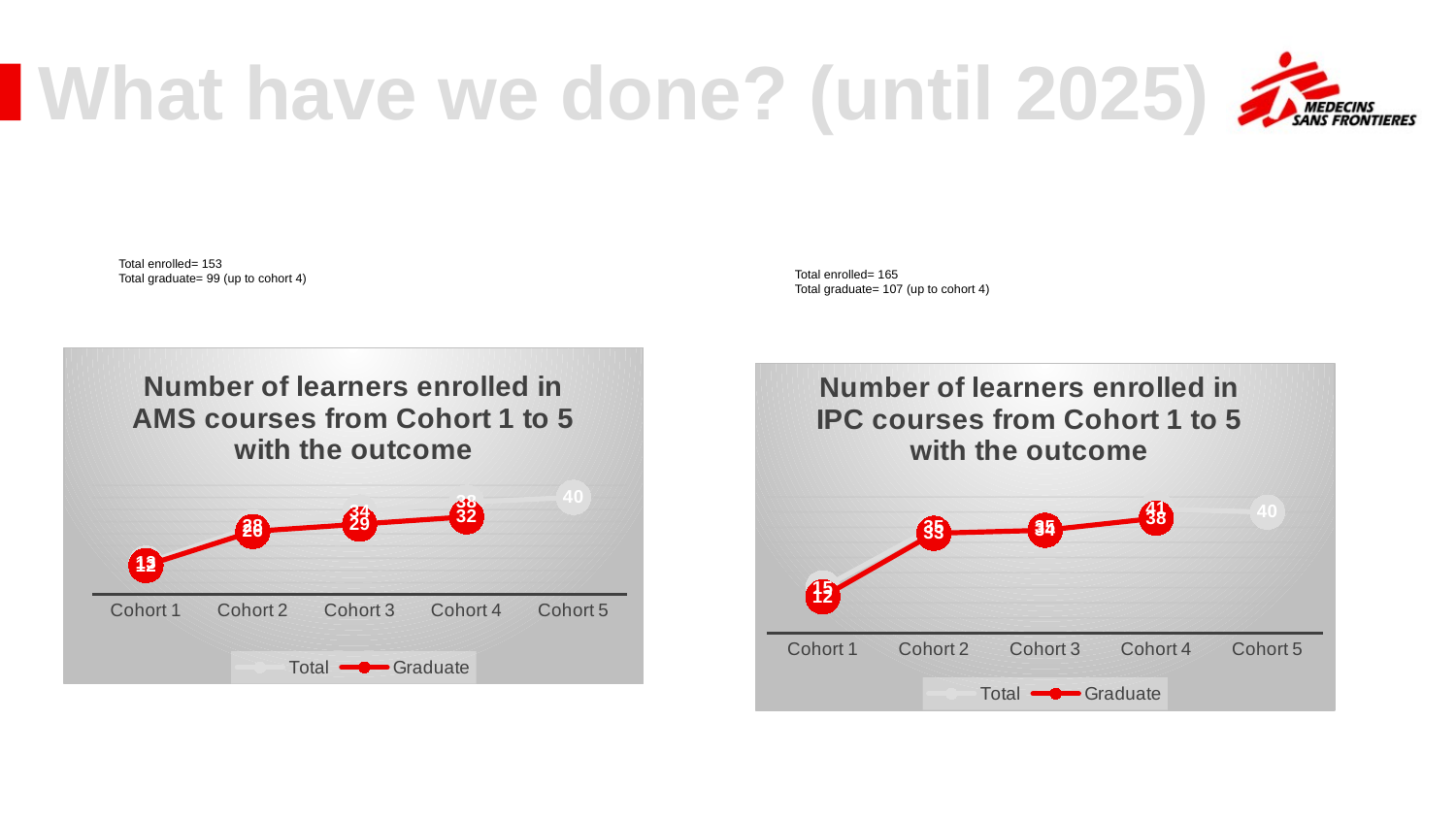
In the AMS courses chart, what is the difference between the Total and Graduate values for Cohort 4? 6 In the AMS courses chart, which cohort has the highest Total value? Cohort 5 In the IPC courses chart, what is the Total value for Cohort 4? 41 In the AMS courses chart, what is the Total value for Cohort 4? 38 In the AMS courses chart, what is the Graduate value for Cohort 3? 29 In the IPC courses chart, what is the difference between the Total and Graduate values for Cohort 4? 3 How many series does the legend of the AMS courses chart list? 2 In the IPC courses chart, what is the Graduate value for Cohort 4? 38 What kind of chart is the 'Number of learners enrolled in AMS courses from Cohort 1 to 5 with the outcome' chart? Line chart How many cohorts are shown on the x axis of the IPC courses chart? 5 In the AMS courses chart, does the Total series rise or fall from Cohort 1 to Cohort 5? Rise In the IPC courses chart, is the Total value larger for Cohort 4 or Cohort 5? Cohort 4